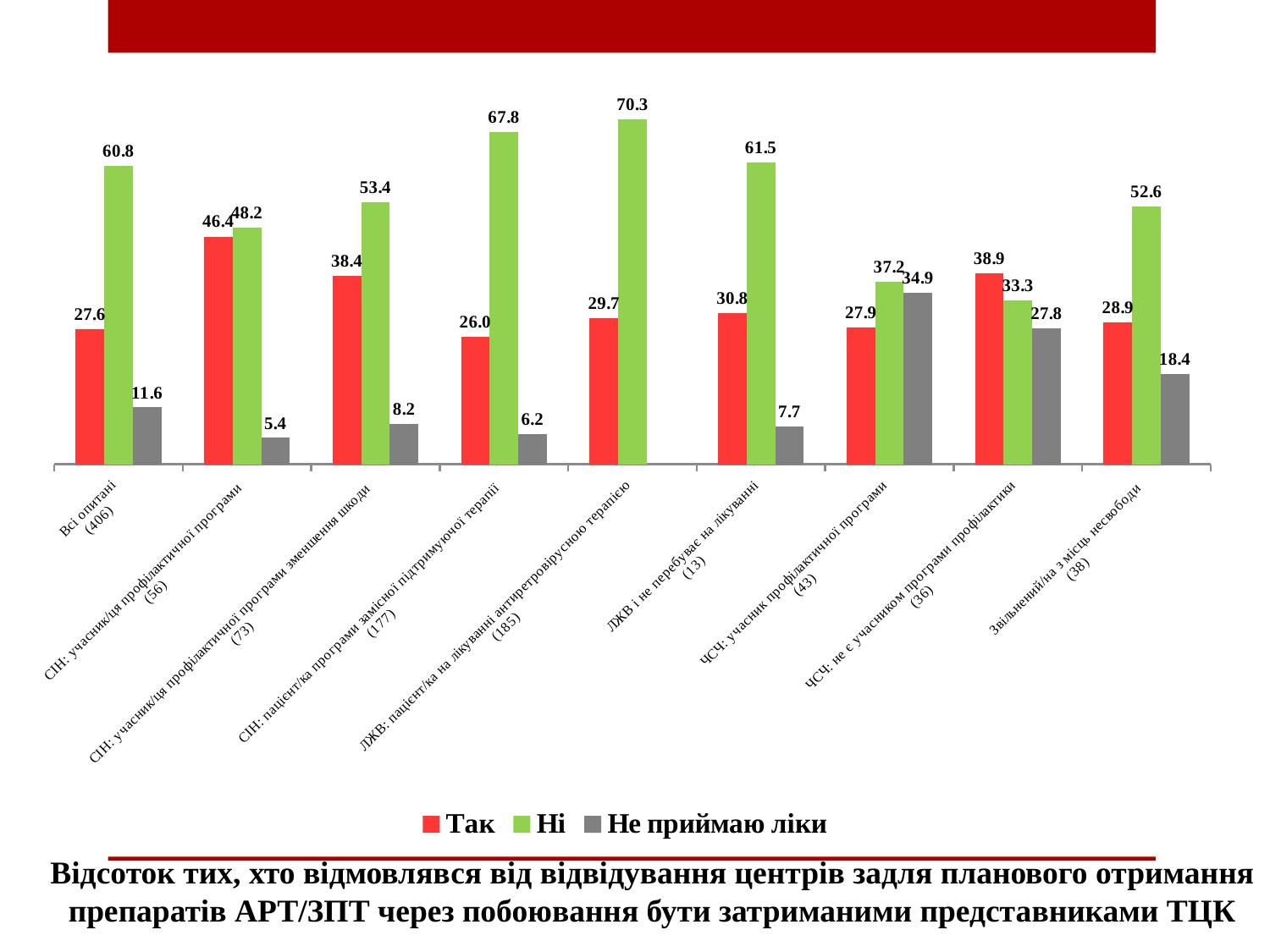
What kind of chart is shown on the slide? Bar chart Which category has the highest value in the "Так" series? СІН: учасник/ця профілактичної програми (56) What is the value of the "Так" series for "Всі опитані (406)"? 27.6 Which series is shown in green in the legend? Ні What is the value of the "Не приймаю ліки" series for "ЧСЧ: учасник профілактичної програми (43)"? 34.9 How many series does the legend list? 3 What is the value of the "Ні" series for "Звільнений/на з місць несвободи (38)"? 52.6 For "ЧСЧ: не є учасником програми профілактики (36)", which is larger, the "Так" value or the "Ні" value? Так How many categories are shown on the x axis? 9 What is the difference between the "Ні" and "Так" values for "Всі опитані (406)"? 33.2 Which category has the highest value in the "Ні" series? ЛЖВ: пацієнт/ка на лікуванні антиретровірусною терапією (185) Which category has the lowest value in the "Не приймаю ліки" series? СІН: учасник/ця профілактичної програми (56)